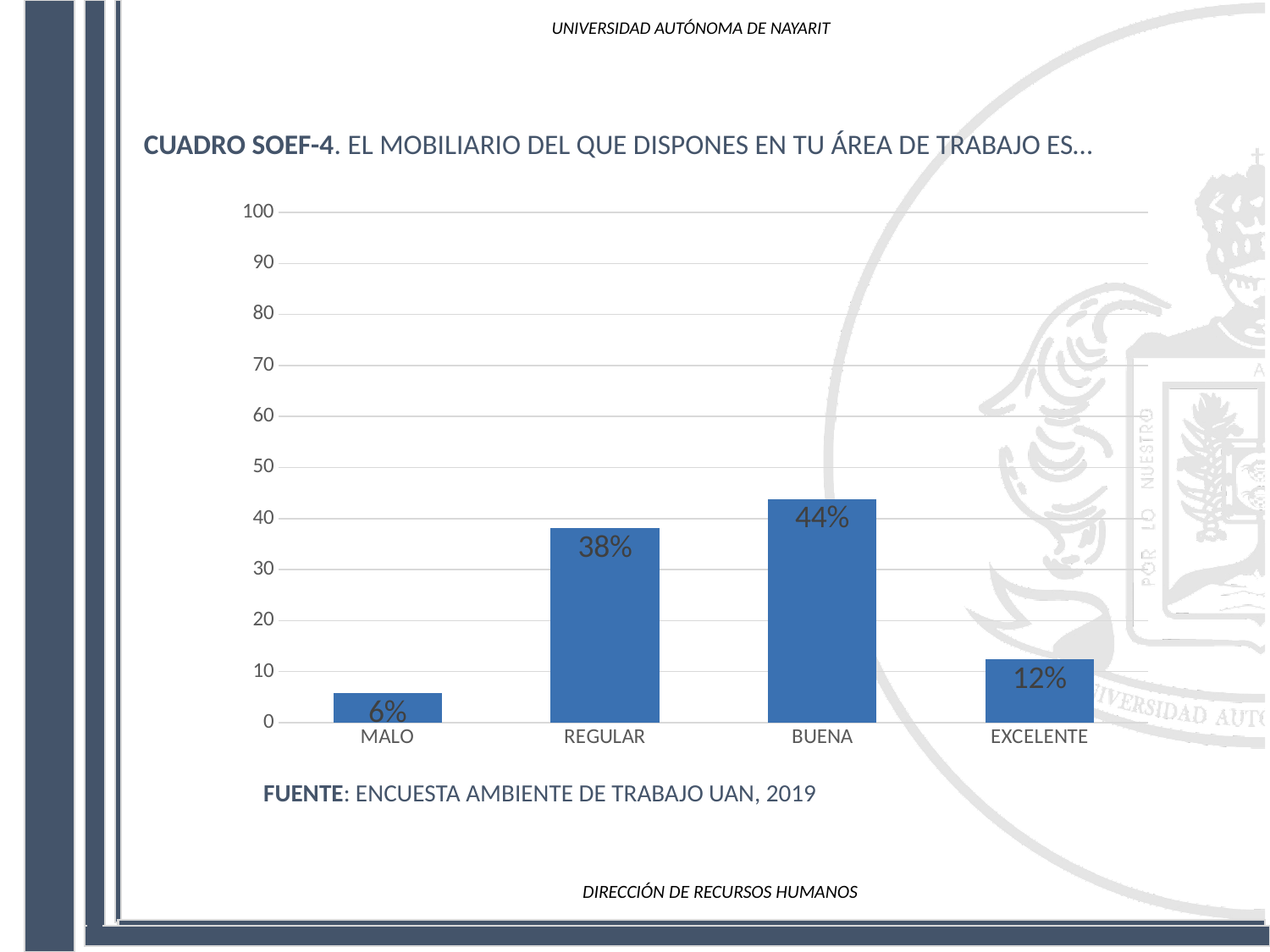
What is the source cited below the chart? ENCUESTA AMBIENTE DE TRABAJO UAN, 2019 What is the difference between the values for EXCELENTE and MALO? 6% What is the value for MALO? 6% What is the value for EXCELENTE? 12% How many categories are shown on the x axis? 4 What is the difference between the values for BUENA and REGULAR? 6% Is the value for BUENA greater or less than 40? greater Which category has the highest value? BUENA Which is larger, the value for REGULAR or the value for EXCELENTE? REGULAR What is the value for REGULAR? 38% Which category has the lowest value? MALO What kind of chart is shown on the slide? bar chart